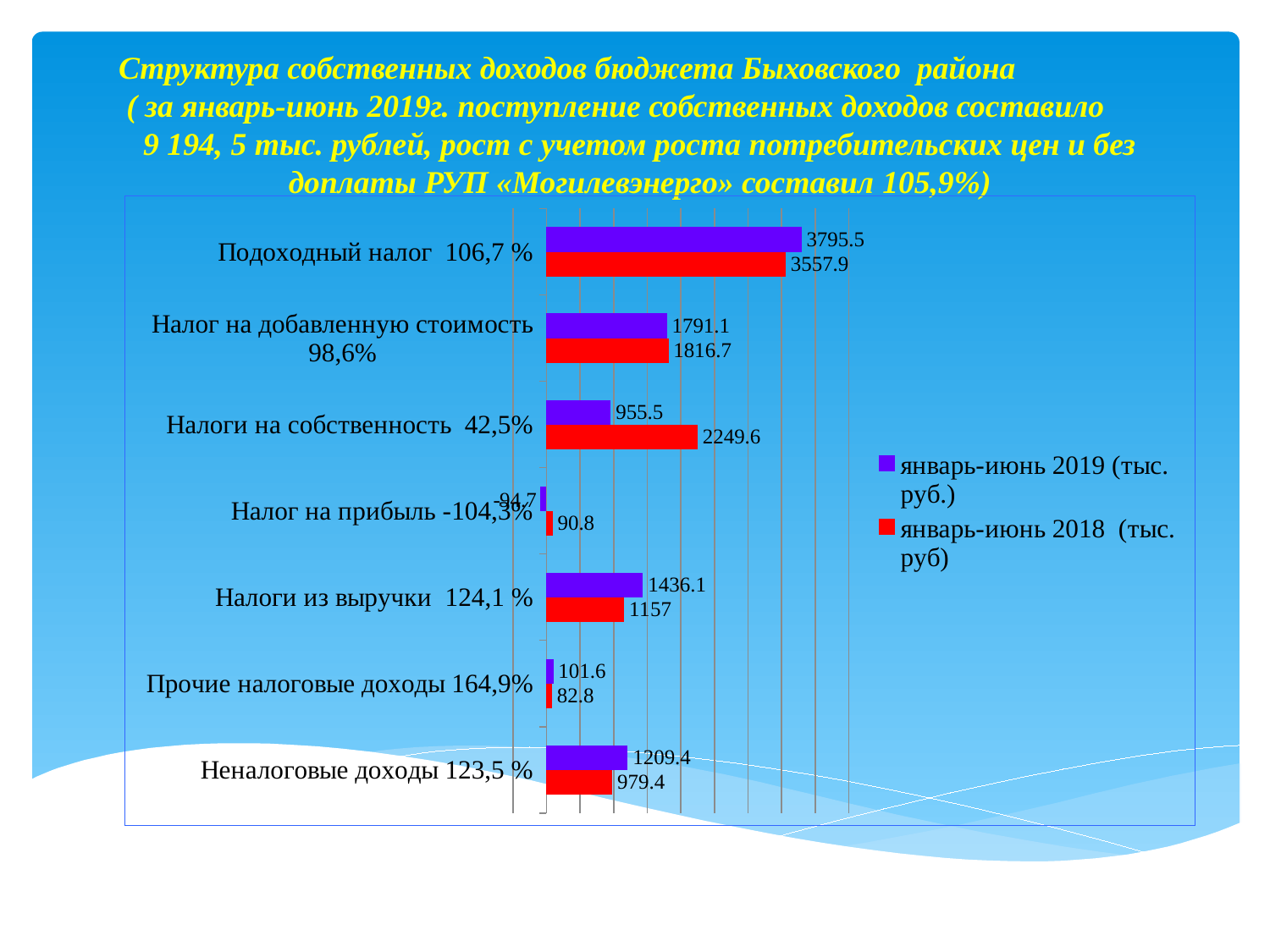
What type of chart is shown on the slide? bar chart What is the value for Налоги на собственность in the январь-июнь 2018 series? 2249.6 What is the value for Подоходный налог in the январь-июнь 2019 series? 3795.5 What is the value for Налоги из выручки in the январь-июнь 2018 series? 1157 How many categories are shown on the chart? 7 Which category has the lowest value in the январь-июнь 2018 series? Прочие налоговые доходы For Налог на добавленную стоимость, which series has the larger value: январь-июнь 2019 or январь-июнь 2018? январь-июнь 2018 What is the difference between the январь-июнь 2019 and январь-июнь 2018 values for Неналоговые доходы? 230 What colour are the bars for the январь-июнь 2018 series? red What is the value for Прочие налоговые доходы in the январь-июнь 2019 series? 101.6 Which category has the highest value in the январь-июнь 2019 series? Подоходный налог How many series does the legend list? 2